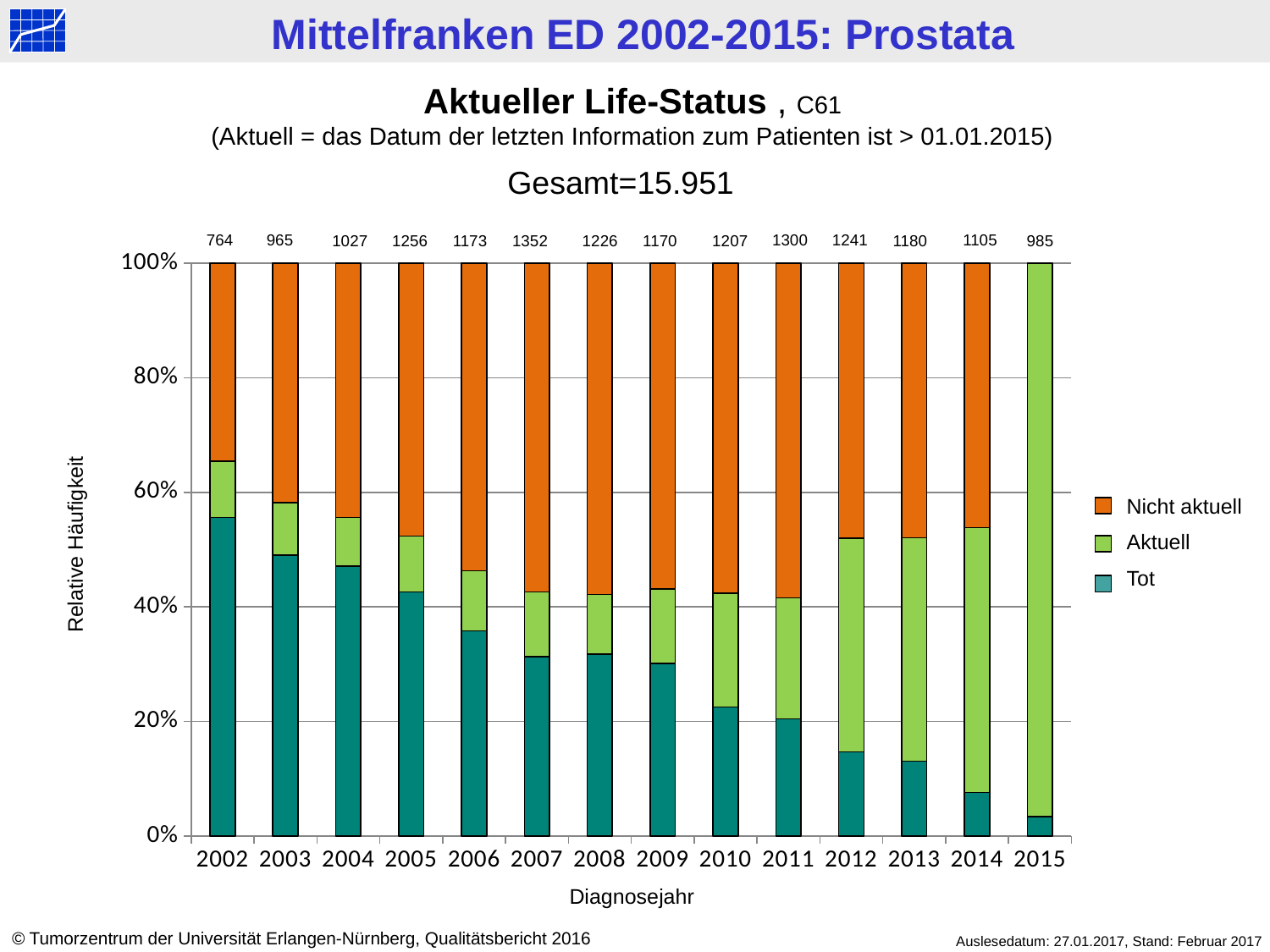
What number is printed above the bar for 2007? 1352 Is the share of 'Tot' in 2002 greater or less than 40%? greater Which diagnosis year has the lowest number printed above its bar? 2002 Which year has the larger number printed above its bar, 2005 or 2011? 2011 How many diagnosis years are shown on the x axis? 14 What number is printed above the bar for 2002? 764 What kind of chart is shown on the slide? Stacked bar chart What is the difference between the numbers printed above the bars for 2007 and 2002? 588 Does the share of 'Tot' rise or fall from 2002 to 2015? Fall How many series does the legend list? 3 Is the share of 'Tot' in 2015 greater or less than 20%? less Which diagnosis year has the highest number printed above its bar? 2007